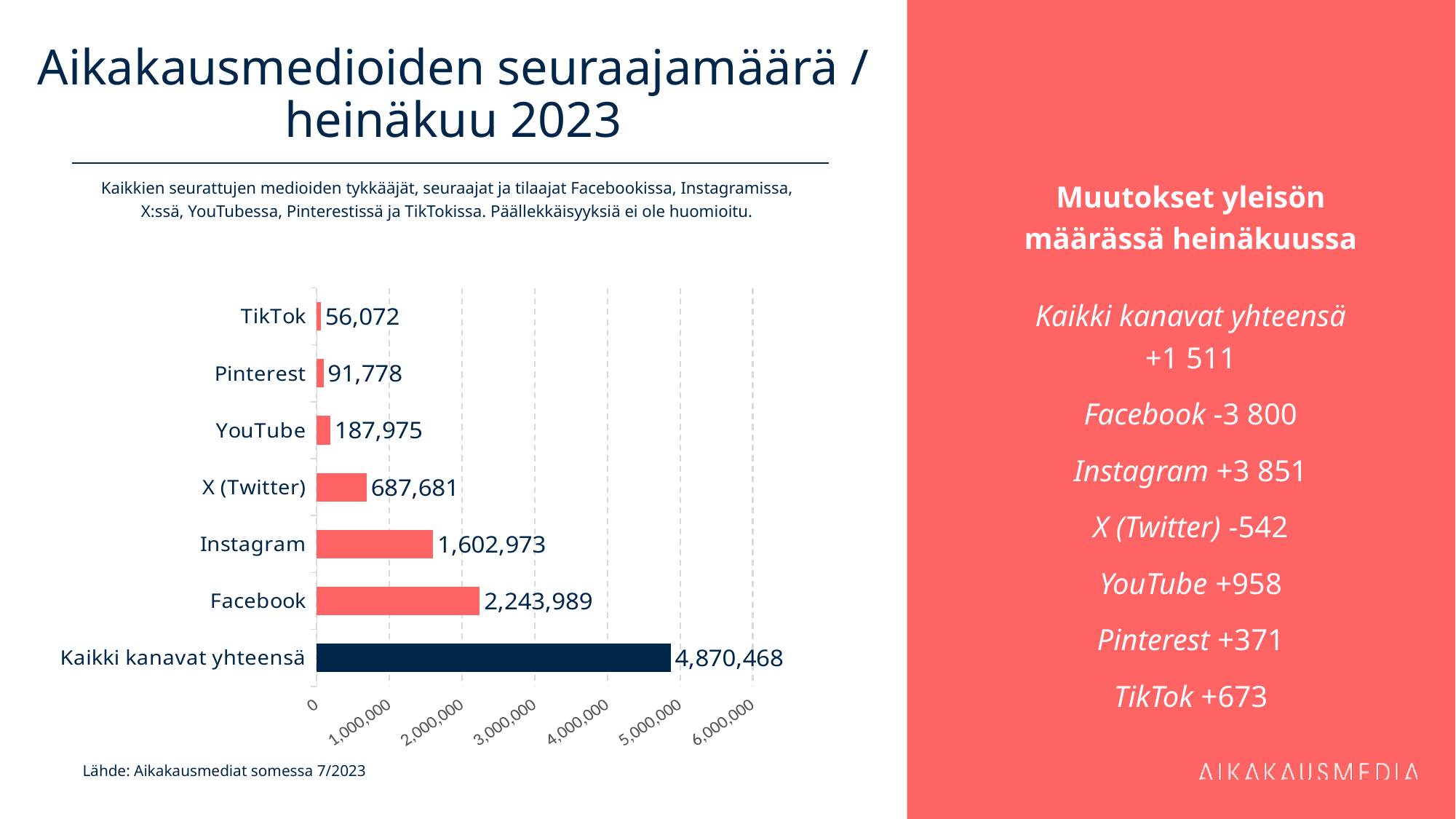
What kind of chart is shown on the slide? bar chart Which is larger, the value for X (Twitter) or the value for YouTube? X (Twitter) What is the value for Instagram? 1,602,973 Which individual channel (excluding the total bar) has the highest value? Facebook What is the difference between the values for Facebook and Instagram? 641,016 How many categories are shown in the chart? 7 What is the difference between the values for YouTube and Pinterest? 96,197 What is the value for Kaikki kanavat yhteensä? 4,870,468 What is the value for TikTok? 56,072 Is the value for Facebook greater or less than 2,000,000? greater Which category has the lowest value? TikTok What is the value for Facebook? 2,243,989